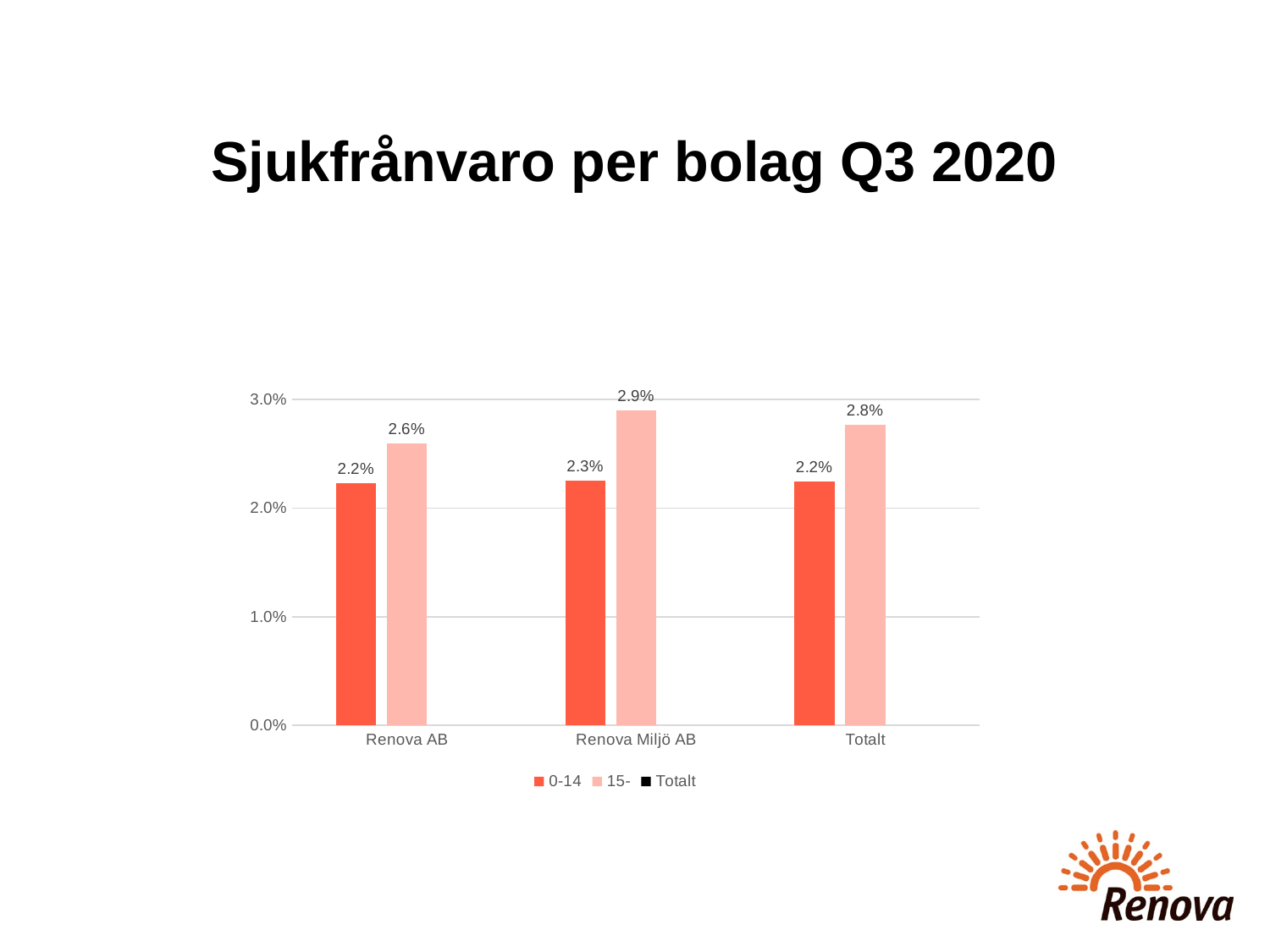
What is the value for the 0-14 series for Renova AB? 2.2% What is the value for the 15- series for Renova Miljö AB? 2.9% What type of chart is shown on the slide? Bar chart Which category has the lowest value for the 15- series? Renova AB How many categories are shown on the x axis? 3 What is the value for the 0-14 series for Renova Miljö AB? 2.3% How many series does the legend list? 3 What is the value for the 15- series for Totalt? 2.8% Which category has the highest value for the 15- series? Renova Miljö AB What is the difference between the 15- and 0-14 values for Renova Miljö AB? 0.6% What is the difference between the 15- and 0-14 values for Renova AB? 0.4% For Totalt, which is larger: the 0-14 value or the 15- value? 15-